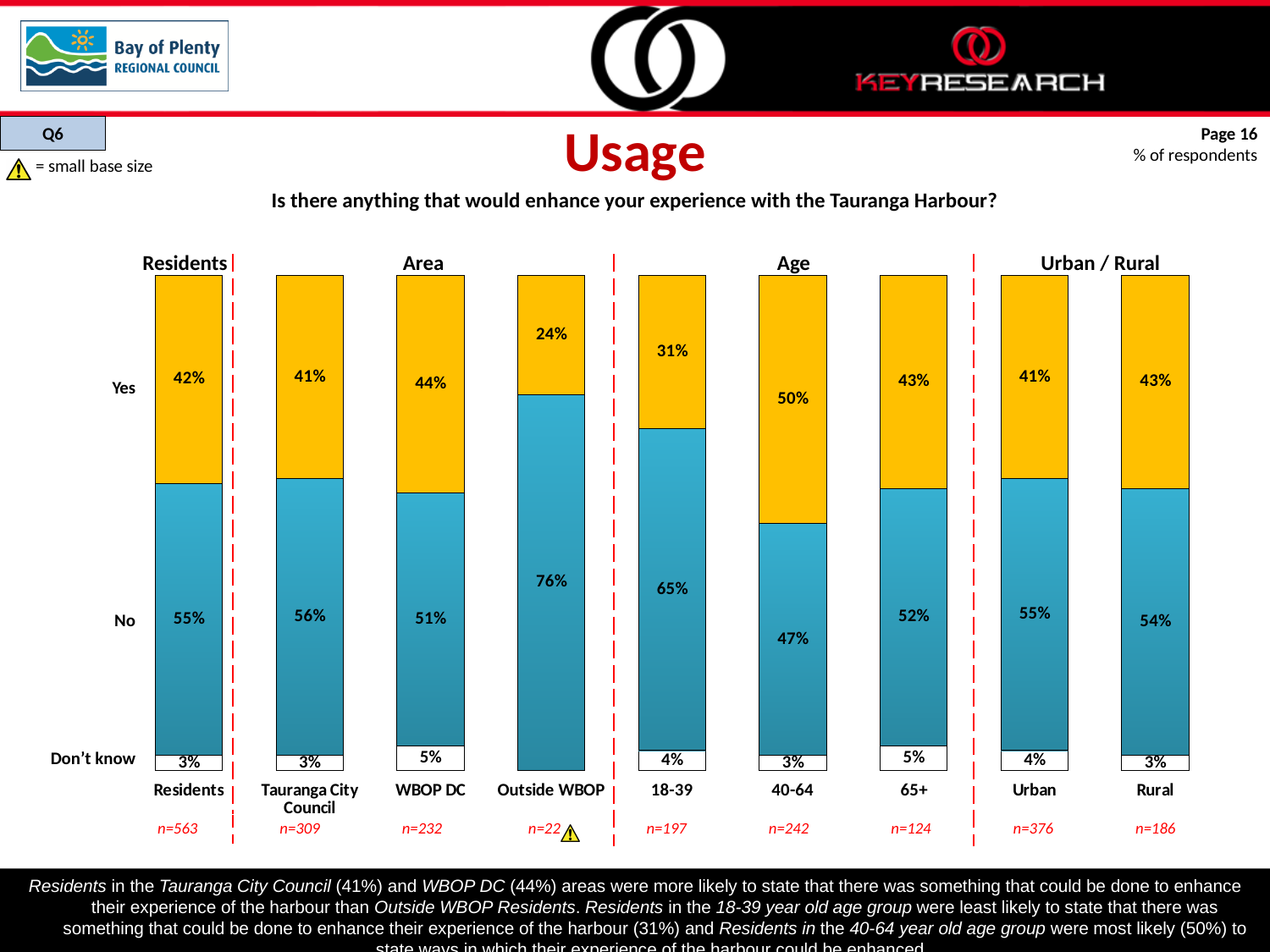
What is the "No" value for the Outside WBOP group? 76% Which colour represents the "Yes" response in the chart? Yellow Which has a higher "No" percentage, Urban or Rural? Urban What is the difference between the "Yes" percentages for the 40-64 and 18-39 age groups? 19% What is the "Don't know" value for the 65+ age group? 5% Which group has the lowest "Yes" percentage? Outside WBOP How many groups (bars) are shown in the chart? 9 What is the sample size (n) for the Outside WBOP group? n=22 What type of chart is shown on the slide? Stacked bar chart Which group has the highest "Yes" percentage? 40-64 What percentage of Residents answered "Yes" to whether anything would enhance their experience with the Tauranga Harbour? 42% How many response categories are stacked in each bar? 3